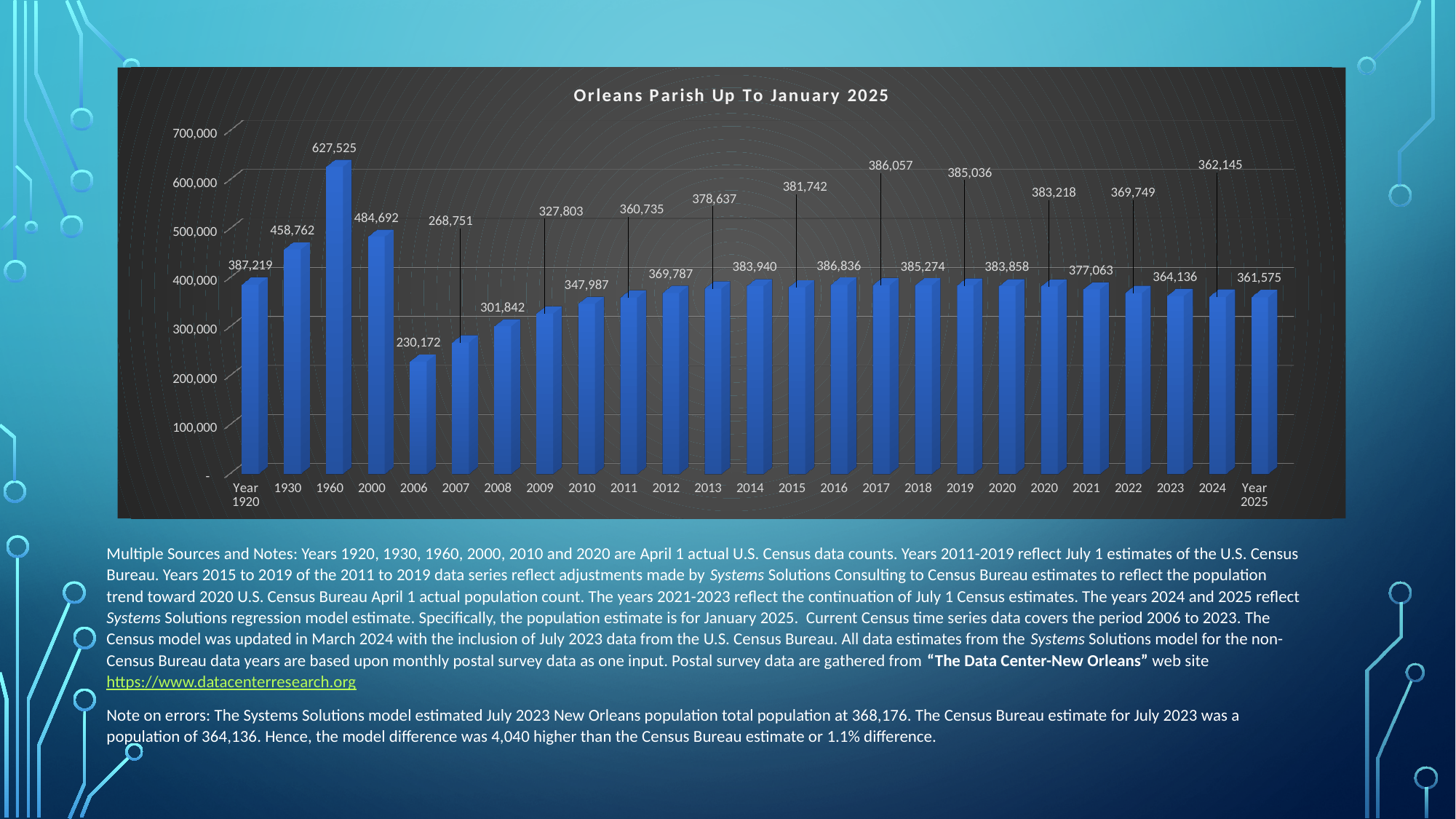
Which year has the lowest value in the Orleans Parish chart? 2006 What is the value for 1960 in the Orleans Parish chart? 627,525 Is the value for 2006 greater or less than 300,000? less What kind of chart is shown on the slide? Bar chart What is the value for 2006 in the Orleans Parish chart? 230,172 How many bars are plotted in the Orleans Parish chart? 25 Which year has the highest value in the Orleans Parish chart? 1960 What is the difference between the values for 1960 and 2006? 397,353 Which is larger, the value for 2000 or the value for 1930? 2000 What is the value for 2013 in the Orleans Parish chart? 378,637 What is the value for Year 2025 in the Orleans Parish chart? 361,575 What is the difference between the values for 2000 and 1930? 25,930